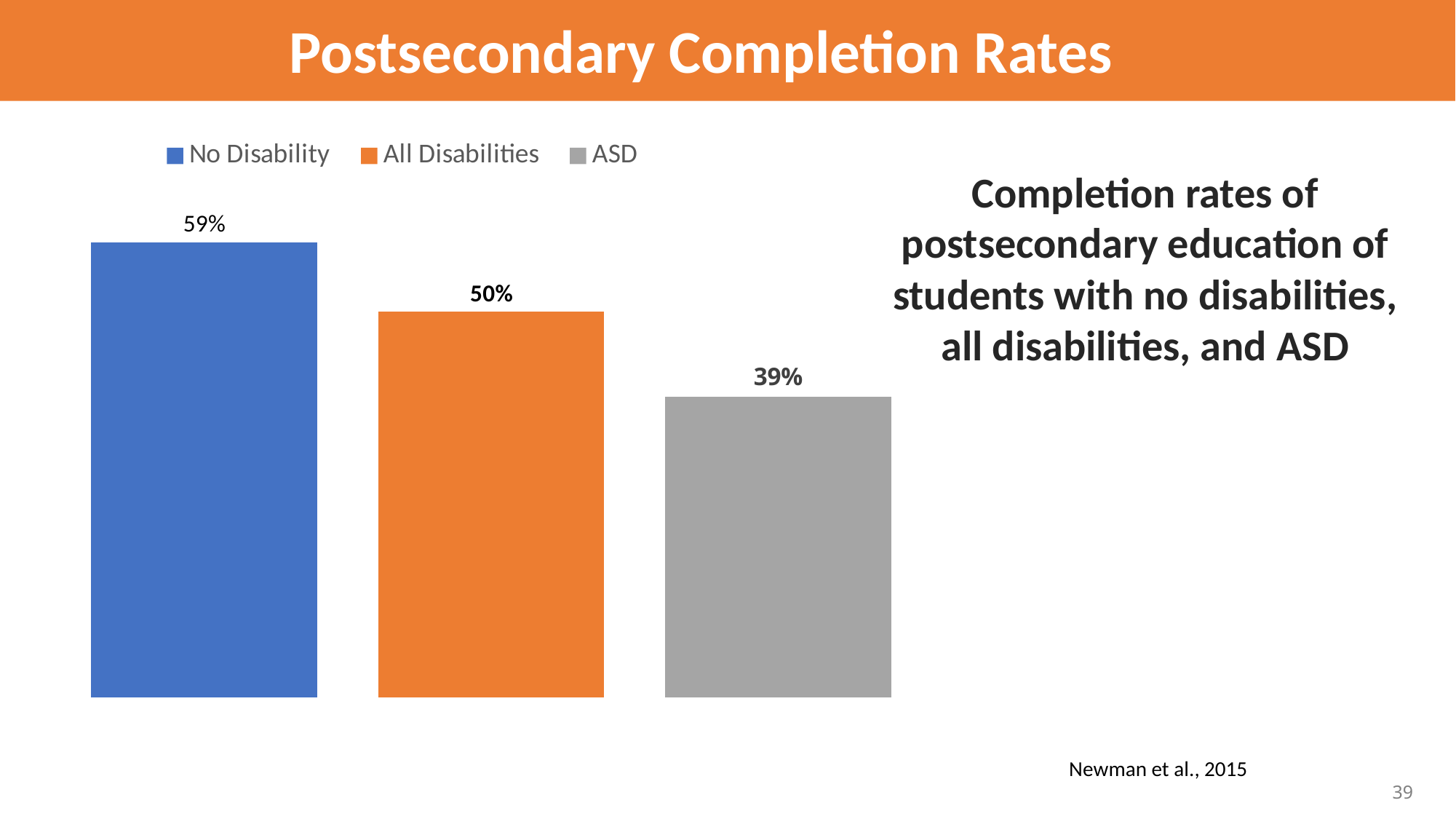
What is the difference between the completion rates for No Disability and ASD? 20% How many entries does the legend list? 3 What is the postsecondary completion rate for No Disability? 59% What is the difference between the completion rates for No Disability and All Disabilities? 9% What is the postsecondary completion rate for ASD? 39% Which is larger, the completion rate for All Disabilities or for ASD? All Disabilities Which group has the highest completion rate? No Disability What colour is the bar for ASD? Gray What is the postsecondary completion rate for All Disabilities? 50% Which group has the lowest completion rate? ASD How many groups are plotted in the chart? 3 What kind of chart is shown on the slide? Bar chart